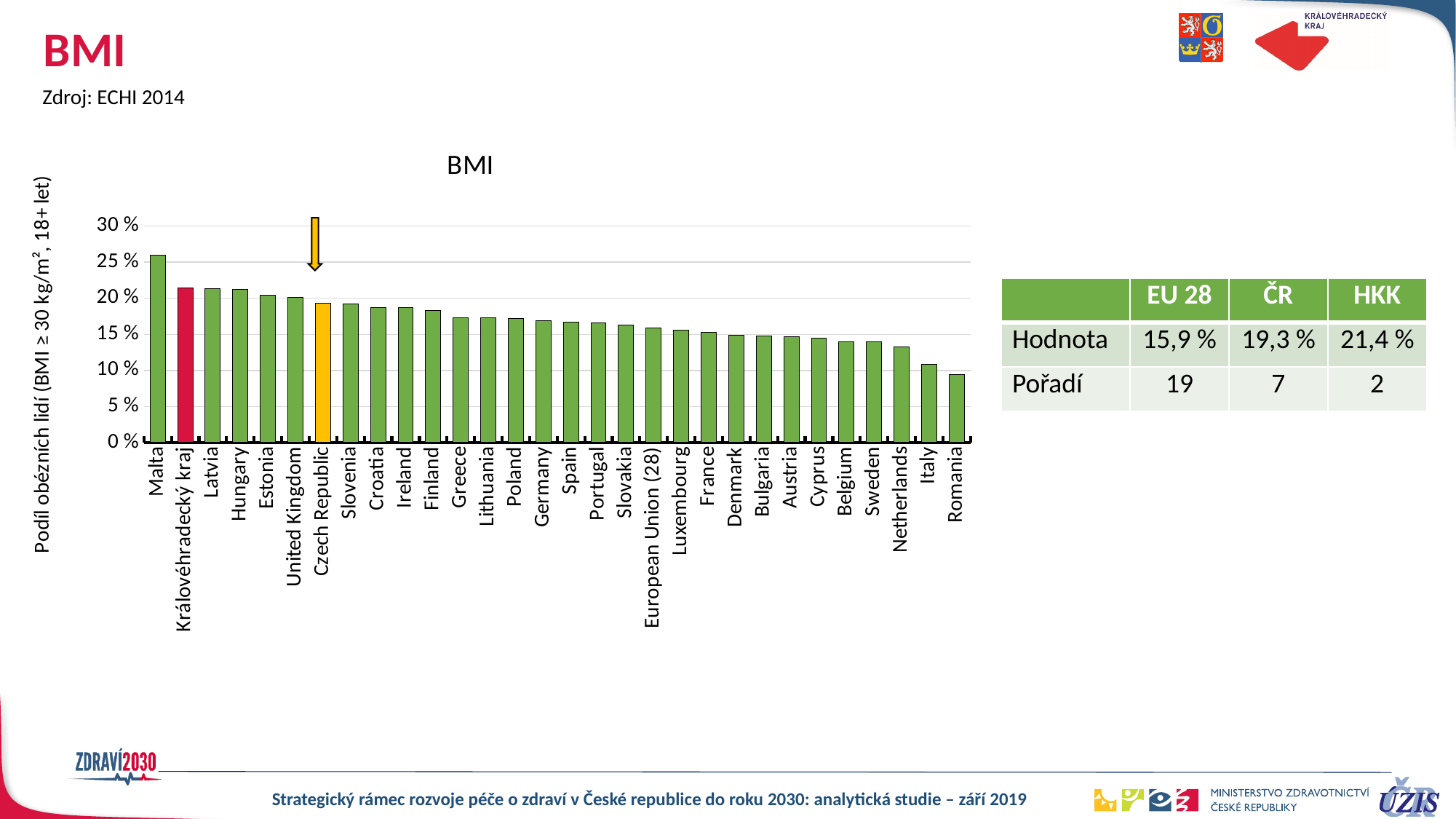
Is the value for Netherlands greater or less than 15 %? less Which is larger, the value for Latvia or the value for Italy? Latvia How many categories are shown on the x axis of the BMI chart? 30 Which category has the lowest value in the BMI chart? Romania What is the value for Královéhradecký kraj in the BMI chart? 21,4 % What kind of chart is shown on the slide? bar chart What is the value for European Union (28) in the BMI chart? 15,9 % Do the values rise or fall from left to right along the x axis? fall Is the value for Malta greater or less than 20 %? greater What is the value for the Czech Republic in the BMI chart? 19,3 % What is the difference between the values for Královéhradecký kraj and the Czech Republic? 2,1 % Which category has the highest value in the BMI chart? Malta